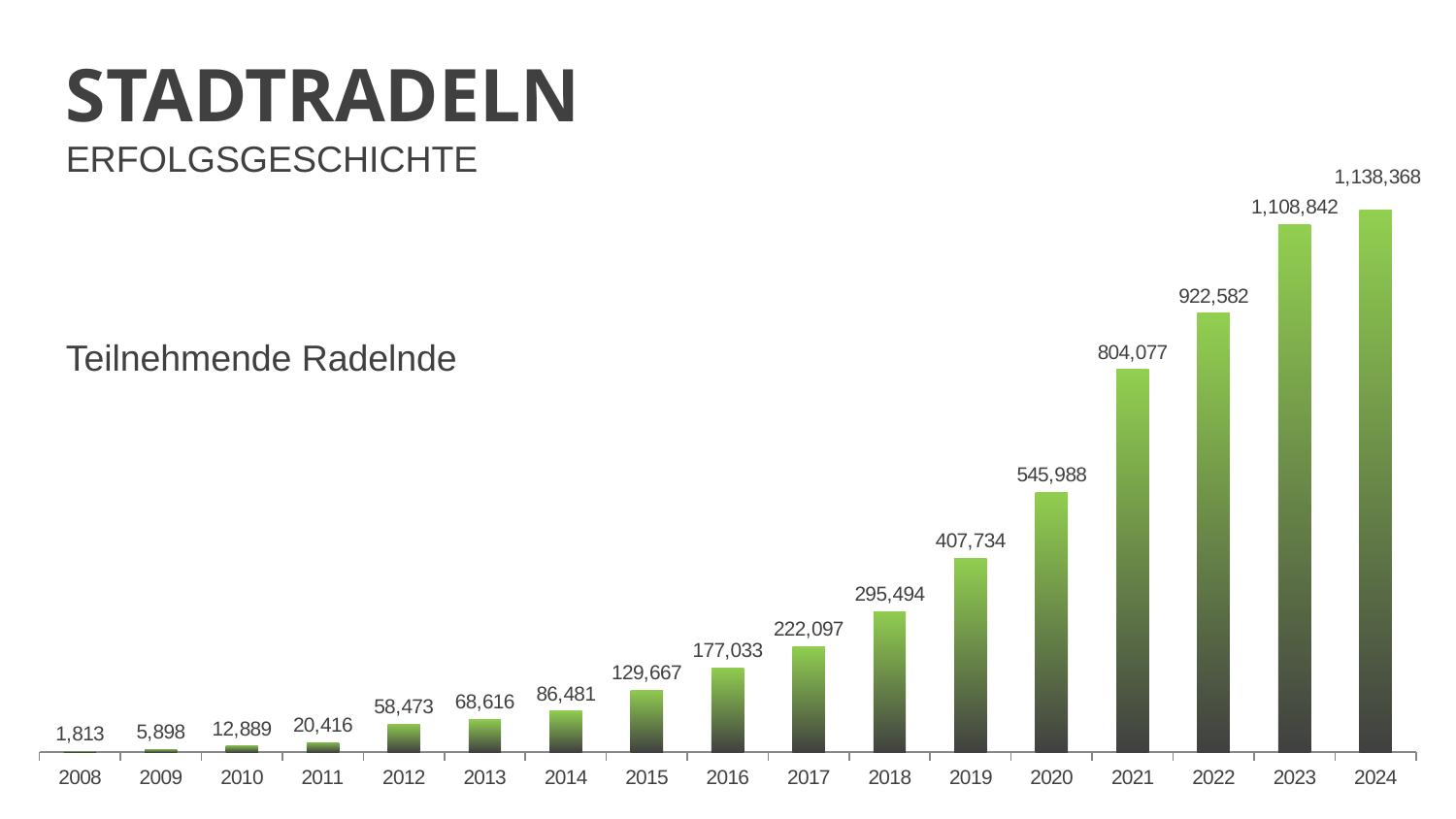
Which is larger, the value for 2019 or the value for 2018? 2019 What is the value for 2024? 1,138,368 What is the difference between the values for 2021 and 2020? 258,089 What is the value for 2008? 1,813 Which year has the lowest value? 2008 Which year has the highest value? 2024 What is the difference between the values for 2024 and 2023? 29,526 What is the value for 2021? 804,077 What is the value for 2015? 129,667 Do the values rise or fall from 2008 to 2024? rise How many years are shown on the x axis? 17 What kind of chart is shown on the slide? bar chart